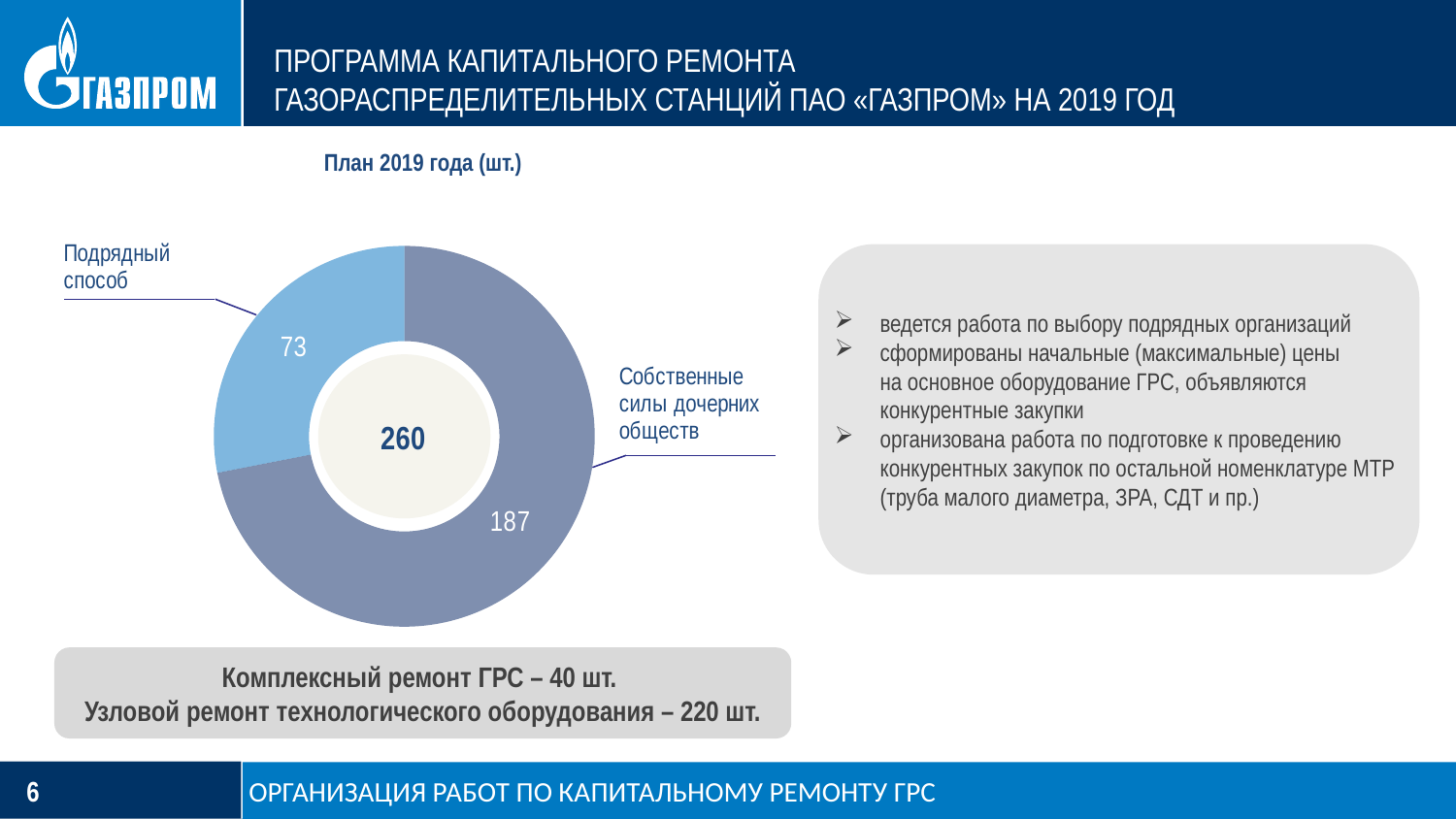
Which colour is used for the Подрядный способ segment? Light blue Which category has the largest share of the chart? Собственные силы дочерних обществ What total is shown in the centre of the chart? 260 What is the difference between the values for Собственные силы дочерних обществ and Подрядный способ? 114 Which is larger: the value for Подрядный способ or for Собственные силы дочерних обществ? Собственные силы дочерних обществ What is the value for Подрядный способ? 73 Which category has the smallest share of the chart? Подрядный способ What kind of chart is shown on the slide? Pie chart (donut) What is the value for Собственные силы дочерних обществ? 187 What is the title of the chart? План 2019 года (шт.) What is the sum of the two segment values shown on the chart? 260 How many categories does the chart show? 2